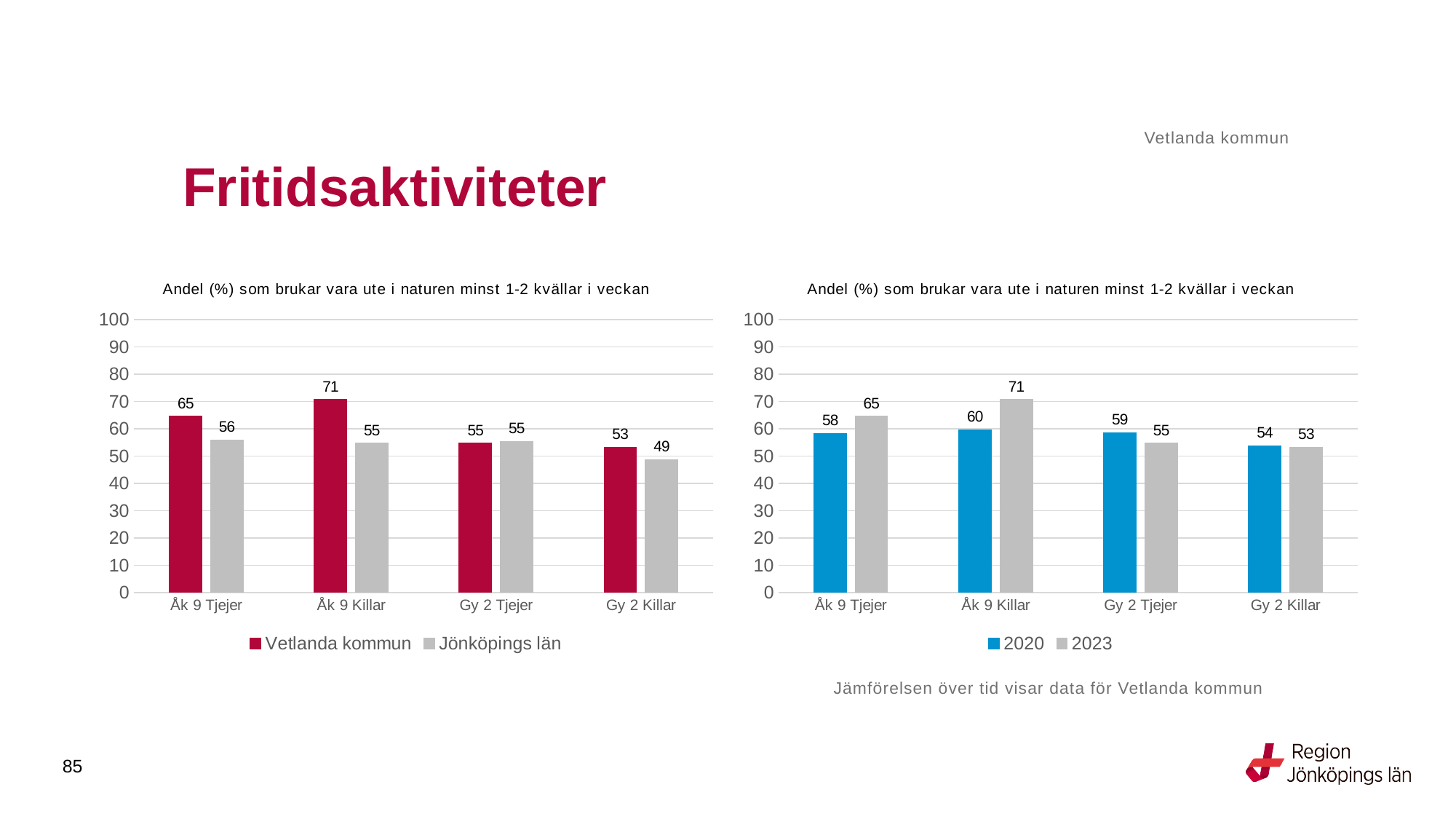
In the left chart, which is larger for Åk 9 Tjejer: Vetlanda kommun or Jönköpings län? Vetlanda kommun In the right chart, what is the value for 2020 for Gy 2 Killar? 54 In the right chart, which category has the highest value for 2023? Åk 9 Killar How many series does the legend of the right chart list? 2 In the right chart, what is the value for 2023 for Åk 9 Tjejer? 65 In the left chart, what is the value for Vetlanda kommun for Åk 9 Killar? 71 In the left chart, which category has the lowest value for Jönköpings län? Gy 2 Killar What kind of chart is the left chart? Bar chart In the left chart, which category has the highest value for Vetlanda kommun? Åk 9 Killar In the left chart, what is the value for Jönköpings län for Gy 2 Killar? 49 In the left chart, what is the difference between Vetlanda kommun and Jönköpings län for Åk 9 Killar? 16 In the right chart, what is the difference between 2023 and 2020 for Åk 9 Killar? 11